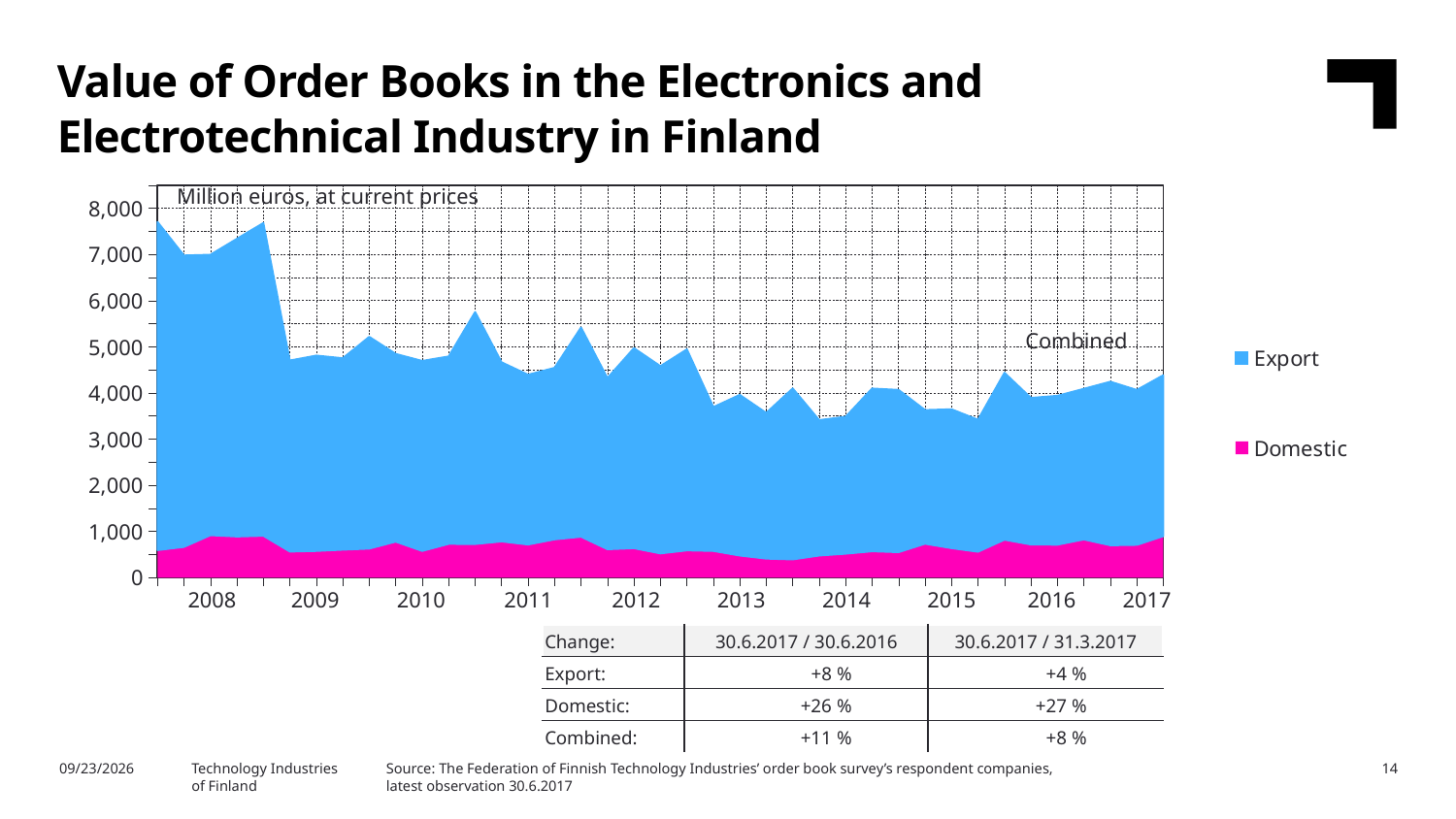
According to the table below the chart, what is the change in Combined order books for 30.6.2017 / 31.3.2017? +8 % Is the Domestic value of order books in 2017 greater or less than 1,000? less How many series does the chart's legend list? 2 What are the two series named in the chart's legend? Export and Domestic Is the combined value of order books in 2013 greater or less than 5,000? less Overall, does the combined value of order books rise or fall from 2008 to 2017? Fall What kind of chart is shown on the slide? Stacked area chart According to the table below the chart, what is the change in Domestic order books for 30.6.2017 / 30.6.2016? +26 % In which year shown on the x axis does the combined value of order books reach its highest level? 2008 What unit is stated at the top of the chart's plot area? Million euros, at current prices Is the combined value of order books in 2017 greater or less than 3,000? greater